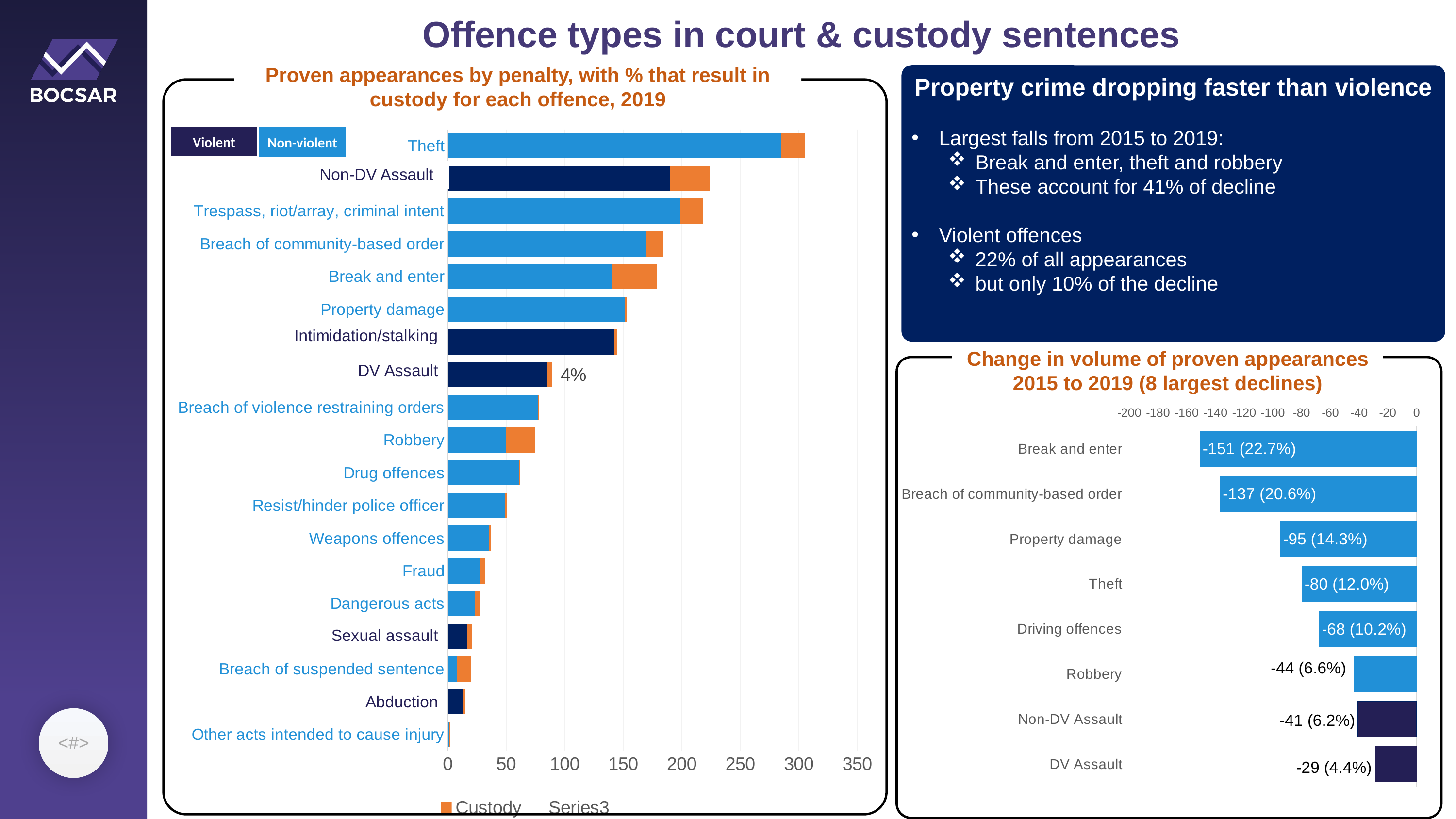
In the 'Change in volume of proven appearances 2015 to 2019' chart, which offence has the largest decline? Break and enter In the 'Change in volume of proven appearances 2015 to 2019' chart, what is the value shown for Theft? -80 (12.0%) In the 'Proven appearances by penalty' chart, is the total bar length for Break and enter greater or less than 200? less In the 'Change in volume of proven appearances 2015 to 2019' chart, which has the larger decline in volume, Robbery or Non-DV Assault? Robbery In the 'Change in volume of proven appearances 2015 to 2019' chart, how many offences are shown? 8 In the 'Change in volume of proven appearances 2015 to 2019' chart, which offence has the smallest decline? DV Assault In the 'Change in volume of proven appearances 2015 to 2019' chart, by how many appearances does the decline for Break and enter exceed the decline for Breach of community-based order? 14 In the 'Change in volume of proven appearances 2015 to 2019' chart, what is the value shown for Break and enter? -151 (22.7%) In the 'Proven appearances by penalty' chart, how many offence categories are listed? 19 What kind of chart is the 'Proven appearances by penalty' chart on the left? bar chart In the 'Change in volume of proven appearances 2015 to 2019' chart, what is the value shown for Driving offences? -68 (10.2%) In the 'Proven appearances by penalty' chart, which offence has the longest bar? Theft